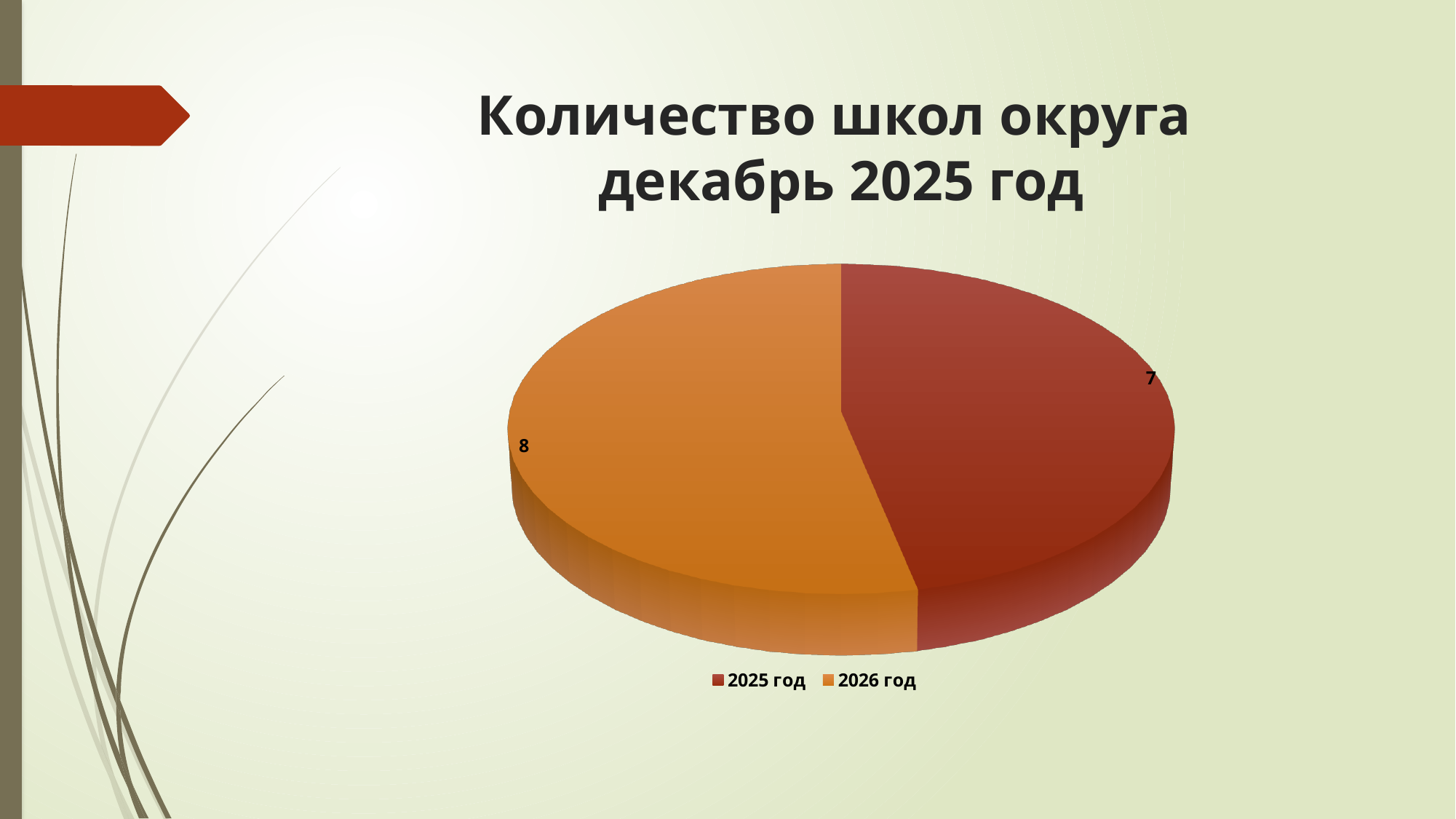
Which is larger, the value for 2025 год or 2026 год? 2026 год How many categories does the pie chart show? 2 What kind of chart is shown on the slide? pie chart What is the total of the two slices? 15 How many entries does the legend list? 2 What is the value for 2025 год? 7 Which category has the highest value? 2026 год What is the difference between the values for 2026 год and 2025 год? 1 What is the value for 2026 год? 8 Which category has the lowest value? 2025 год Which legend entry is shown in dark red? 2025 год What is the title of the chart? Количество школ округа декабрь 2025 год